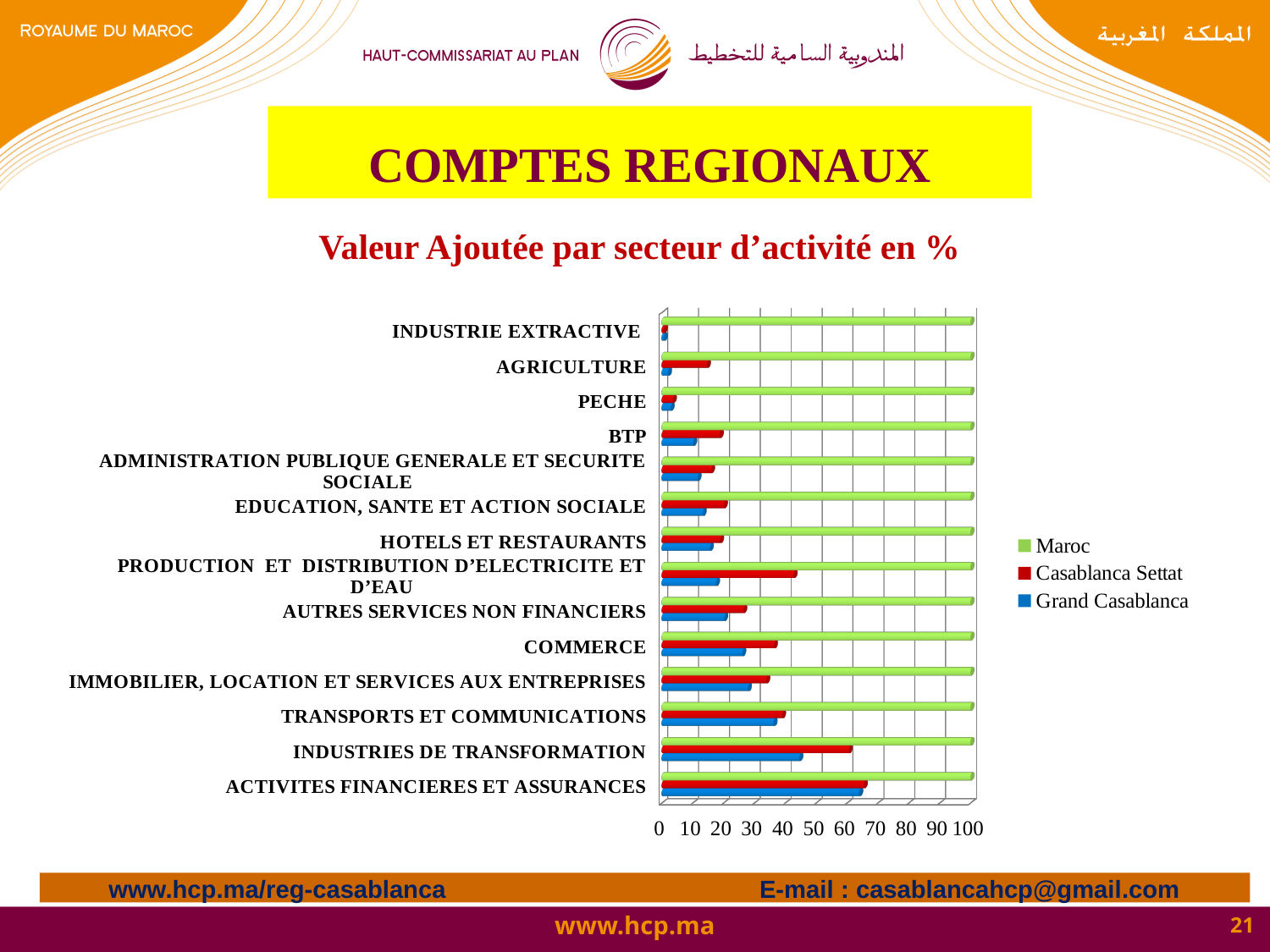
Is the value for Grand Casablanca in INDUSTRIES DE TRANSFORMATION greater or less than 50? less What is the value for Maroc in the AGRICULTURE category? 100 What is the value for Maroc in the ACTIVITES FINANCIERES ET ASSURANCES category? 100 How many series does the legend list? 3 What kind of chart is shown on the slide? bar chart Which category has the lowest value for Casablanca Settat? INDUSTRIE EXTRACTIVE Is the value for Casablanca Settat in ACTIVITES FINANCIERES ET ASSURANCES greater or less than 60? greater How many sectors (categories) are plotted on the chart? 14 In the PRODUCTION ET DISTRIBUTION D'ELECTRICITE ET D'EAU category, which is larger: Casablanca Settat or Grand Casablanca? Casablanca Settat What colour represents the Maroc series in the legend? green Which category has the highest value for Casablanca Settat? ACTIVITES FINANCIERES ET ASSURANCES Is the value for Casablanca Settat in INDUSTRIE EXTRACTIVE greater or less than 10? less